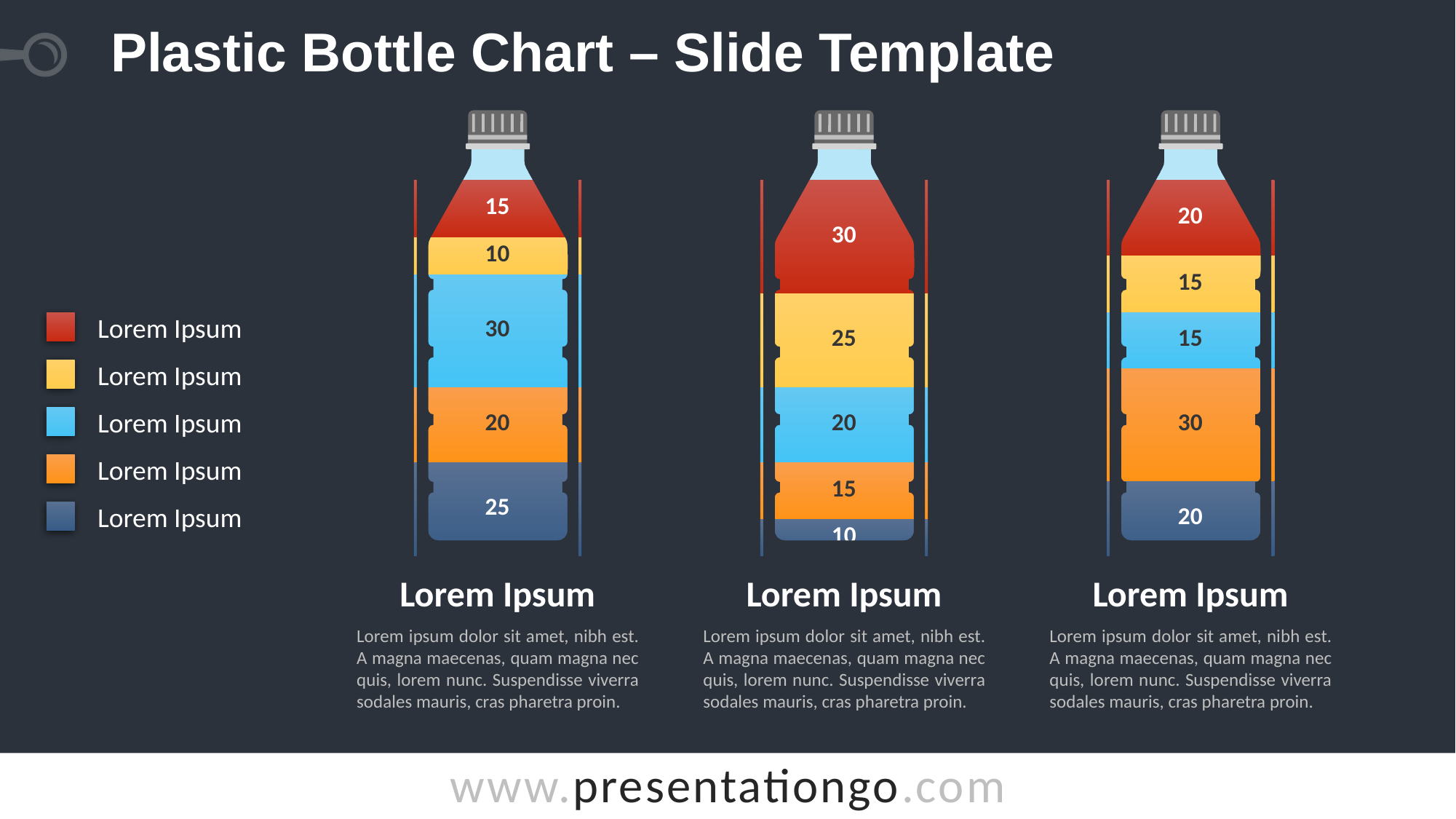
In the middle bottle chart, which coloured segment has the smallest value? Dark blue In the right bottle chart, which is larger: the red segment or the orange segment? Orange How many series does the legend list? 5 How many bottle charts are shown on the slide? 3 In the middle bottle chart, what value is shown in the yellow segment? 25 In the middle bottle chart, which coloured segment has the largest value? Red What kind of chart is used on this slide? Stacked bar chart (bottle-shaped) In the left bottle chart, what value is shown in the dark blue (bottom) segment? 25 In the left bottle chart, what is the difference between the light blue segment and the yellow segment? 20 In the right bottle chart, what value is shown in the orange segment? 30 In the left bottle chart, what value is shown in the red (top) segment? 15 What is the total of all segments in the middle bottle chart? 100